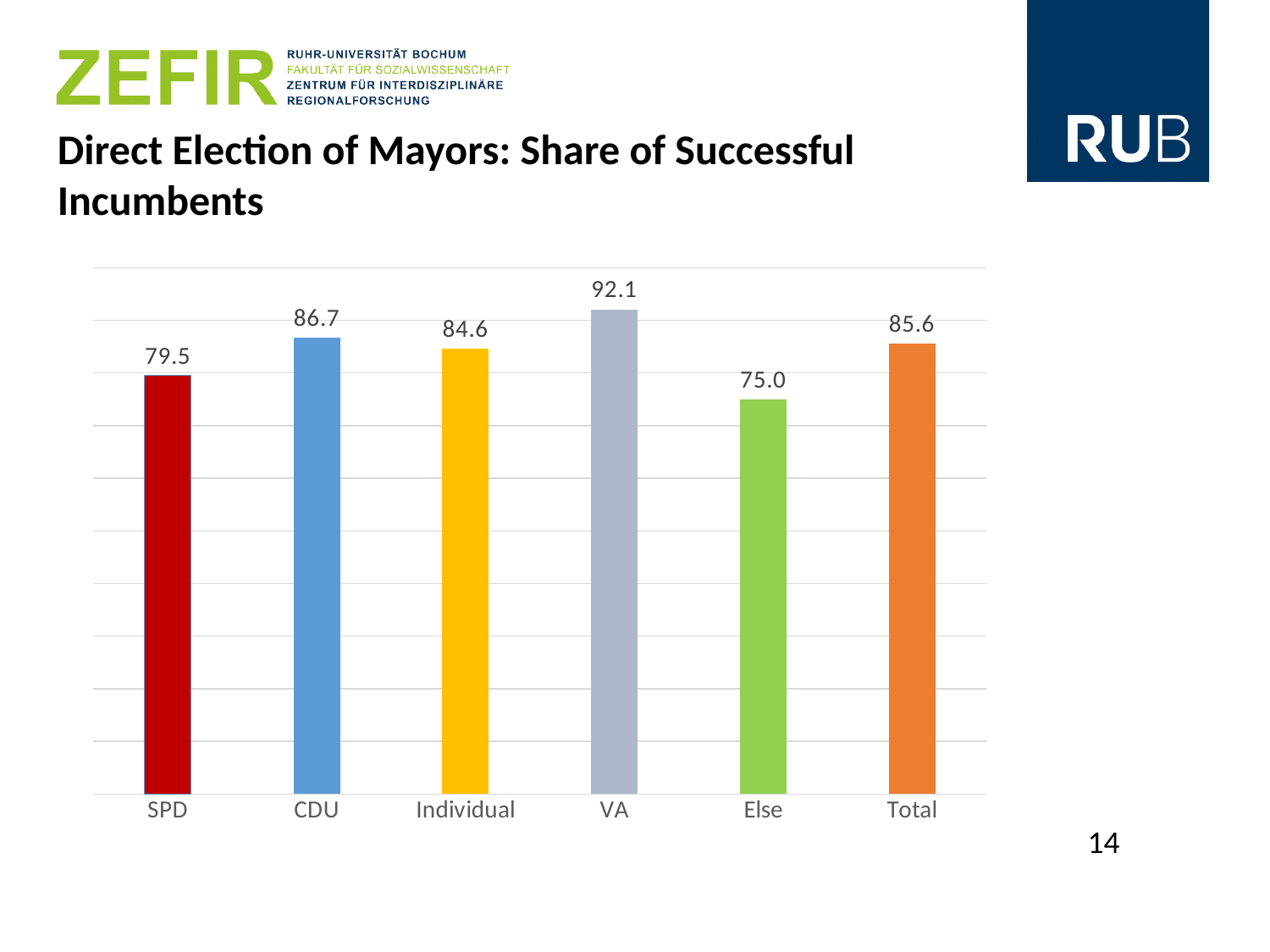
What is the value for Else? 75.0 What is the value for SPD? 79.5 What is the difference between the values for CDU and SPD? 7.2 What is the title of the slide? Direct Election of Mayors: Share of Successful Incumbents What kind of chart is shown on the slide? Bar chart What is the value for VA? 92.1 Which category has the highest value? VA Which category has the lowest value? Else What is the difference between the values for VA and Else? 17.1 What is the value for Total? 85.6 Which is larger, the value for CDU or the value for Individual? CDU How many categories are shown on the x axis? 6